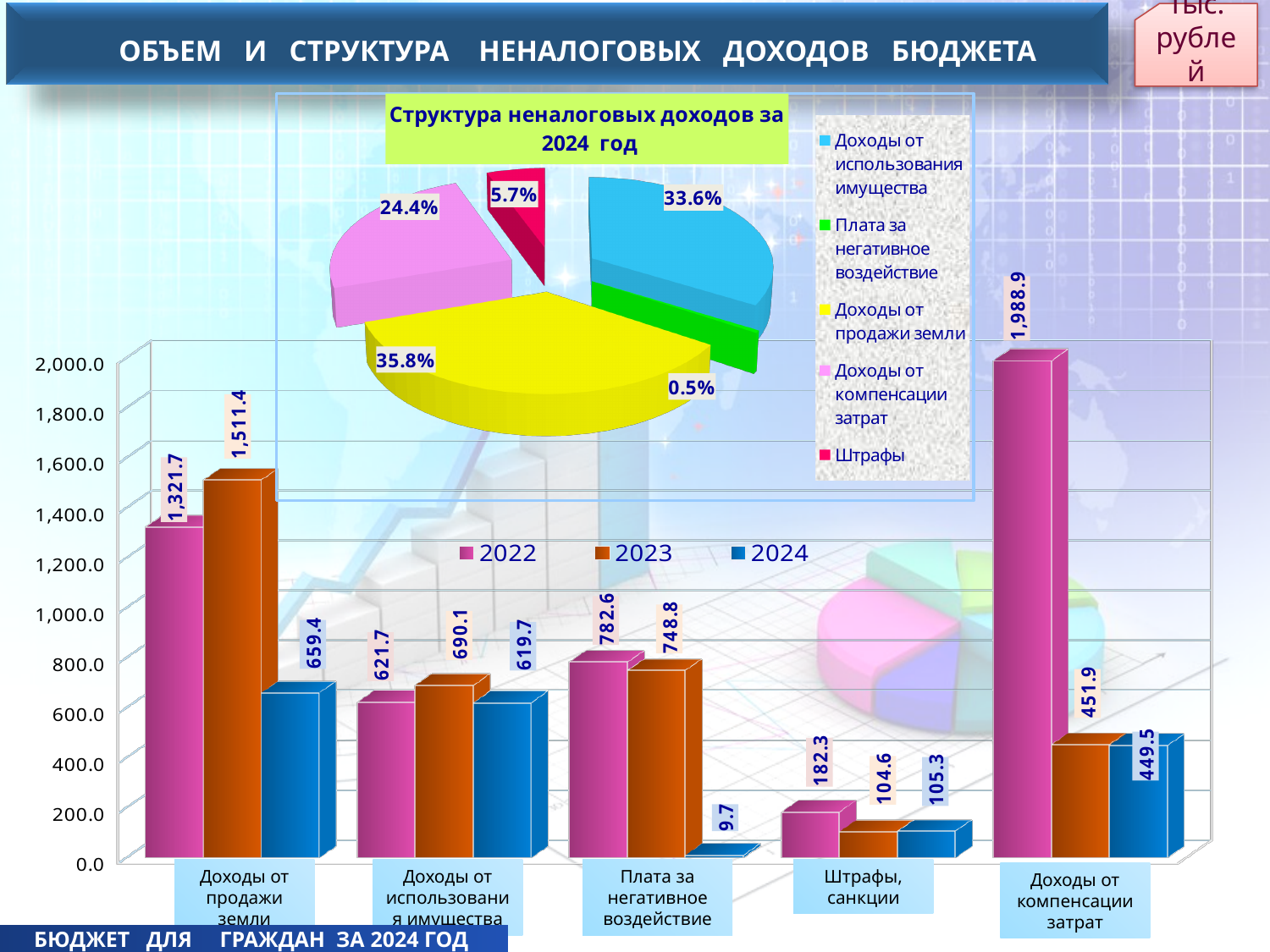
In the pie chart 'Структура неналоговых доходов за 2024 год', which category has the smallest share? Плата за негативное воздействие In the bar chart at the bottom of the slide, do the values for 'Доходы от компенсации затрат' rise or fall from 2022 to 2024? Fall How many categories does the legend of the pie chart 'Структура неналоговых доходов за 2024 год' list? 5 In the pie chart 'Структура неналоговых доходов за 2024 год', what share is shown for 'Доходы от продажи земли'? 35.8% In the bar chart at the bottom of the slide, what is the value for 'Плата за негативное воздействие' in 2024? 9.7 In the bar chart at the bottom of the slide, what is the difference between the 2023 and 2024 values for 'Доходы от продажи земли'? 852.0 In the pie chart 'Структура неналоговых доходов за 2024 год', what share is shown for 'Штрафы'? 5.7% What kind of chart is the chart at the bottom of the slide? Bar chart How many series does the legend of the bar chart at the bottom of the slide list? 3 In the bar chart at the bottom of the slide, which category has the highest value for 2023? Доходы от продажи земли In the bar chart at the bottom of the slide, which is larger for 'Штрафы, санкции': the 2022 value or the 2024 value? 2022 In the bar chart at the bottom of the slide, what is the value for 'Доходы от компенсации затрат' in 2022? 1,988.9